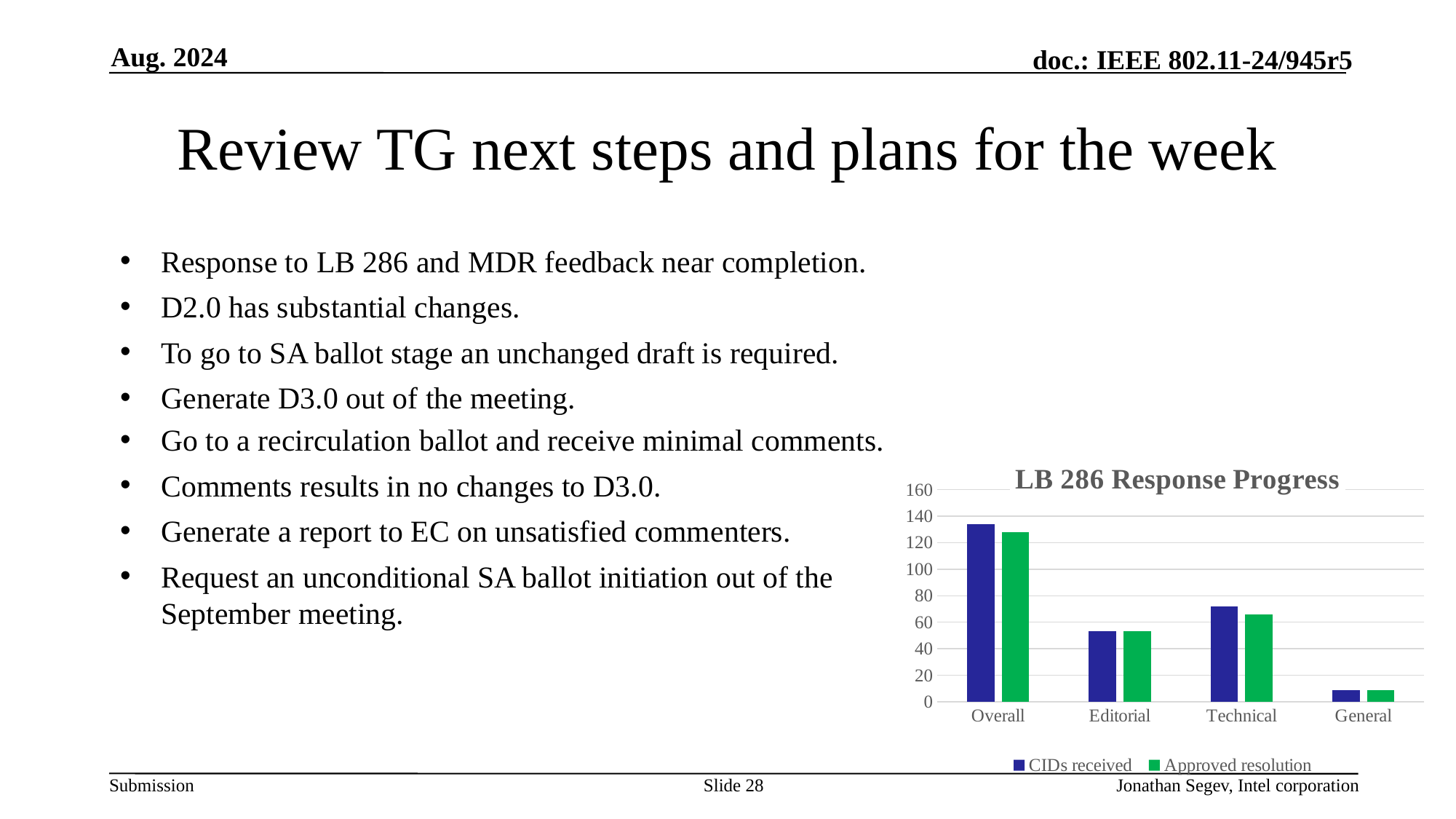
Is the value for CIDs received in the Overall category greater or less than 120? greater What is the title of the chart? LB 286 Response Progress Is the value for CIDs received in the General category greater or less than 20? less How many categories are shown on the x axis of the chart? 4 Is the value for Approved resolution in the Technical category greater or less than 80? less Which category has the highest value for CIDs received? Overall How many series does the chart's legend list? 2 Which is larger: CIDs received for Technical or CIDs received for Editorial? Technical What kind of chart is shown on the slide? bar chart Which is larger: Approved resolution for Overall or Approved resolution for Technical? Overall Which series is shown in green in the chart? Approved resolution Which category has the lowest value for Approved resolution? General